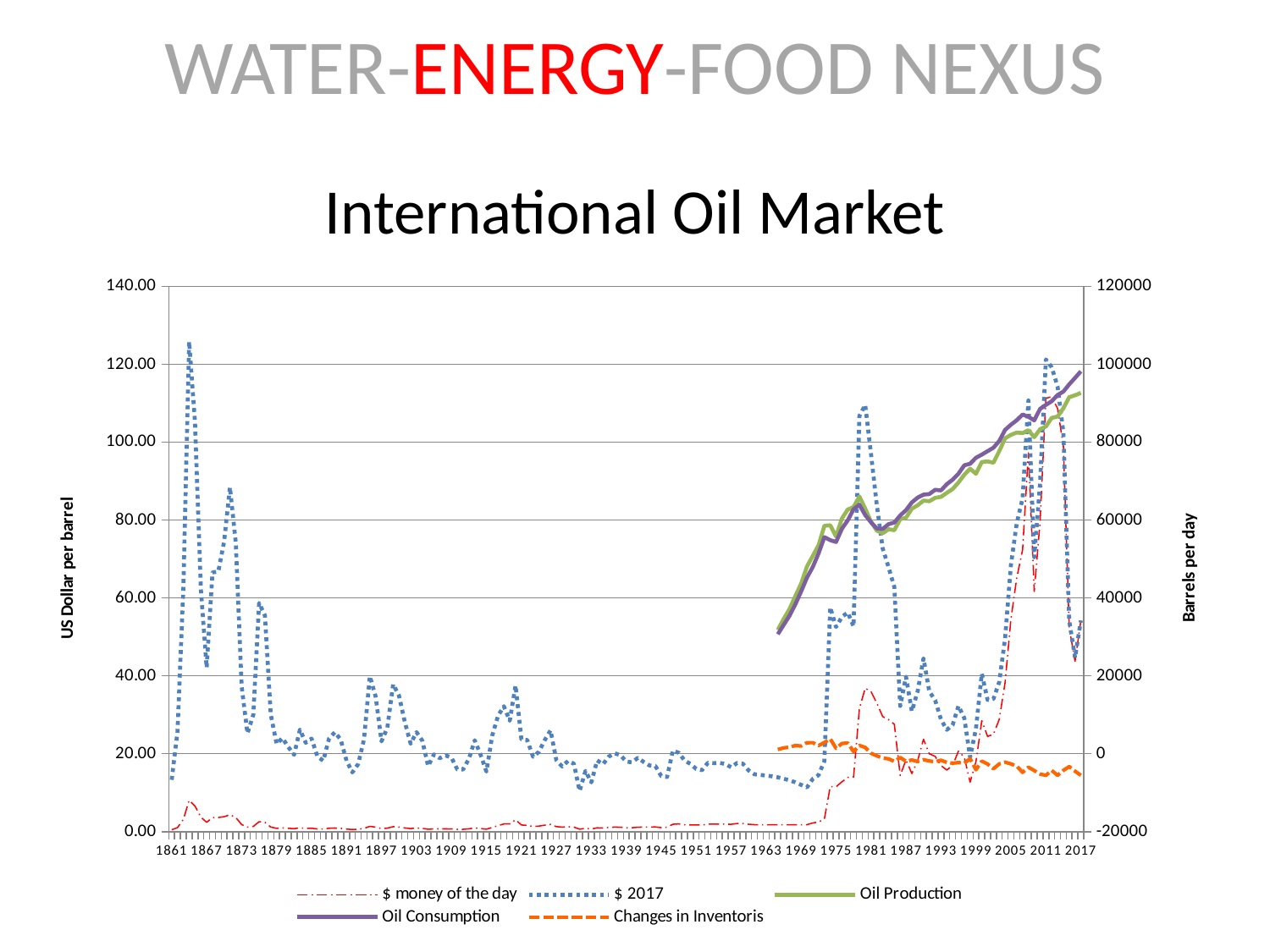
Does the $ 2017 series rise or fall from its 1860s peak to the 1930s? fall What is the label of the left vertical axis of the chart? US Dollar per barrel Does the Oil Consumption series rise or fall overall from the 1960s to 2017? rise Is the $ money of the day value in 1861 greater or less than 20.00? less How many series does the legend of the International Oil Market chart list? 5 Is the Changes in Inventoris series ever greater or less than 20000 on the right axis? less In 2017, which is larger: Oil Consumption or Oil Production? Oil Consumption What kind of chart is shown on the slide? Line chart Is the Oil Consumption value in 2017 greater or less than 80000 barrels per day? greater What is the title of the chart on the slide? International Oil Market